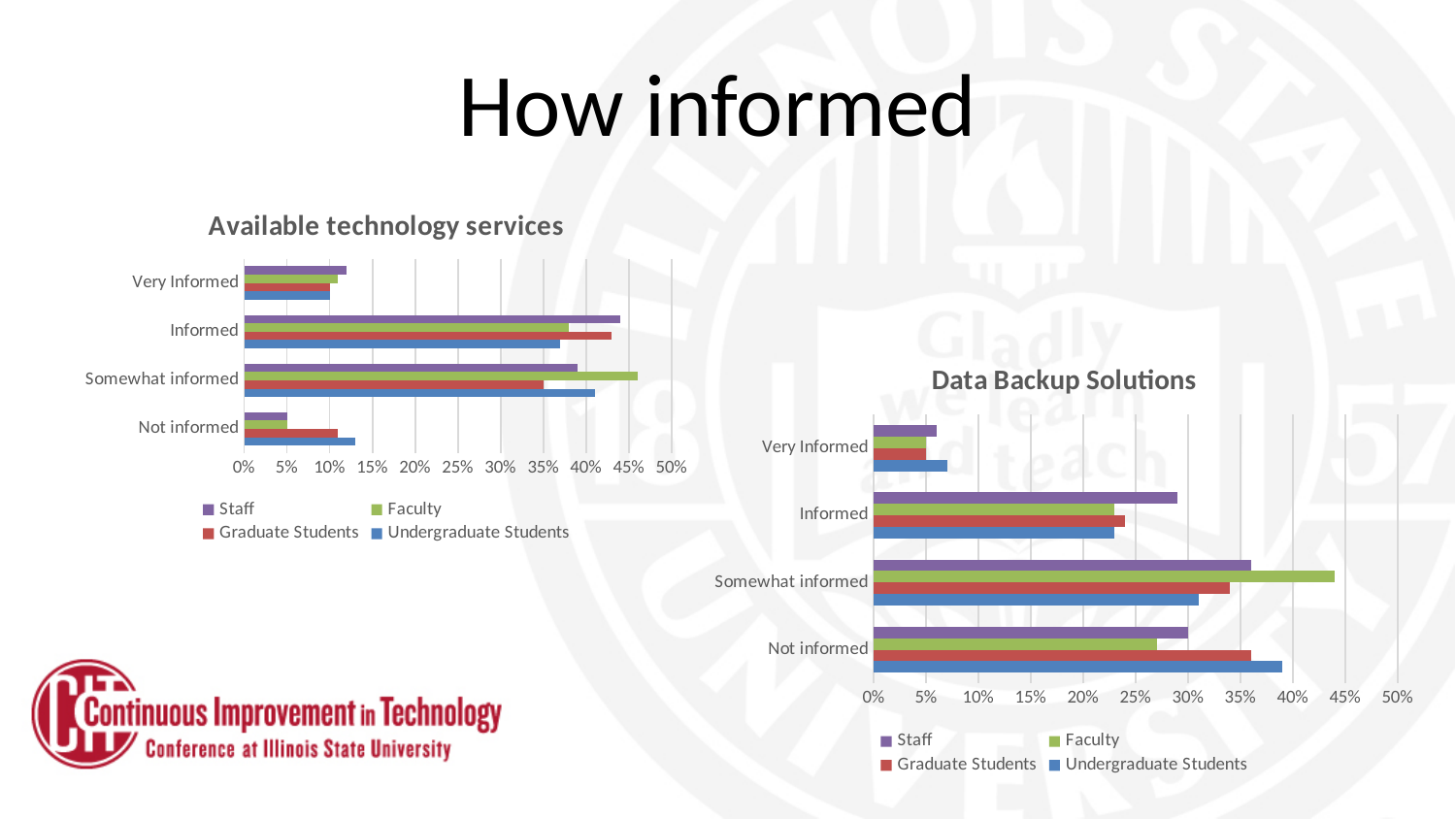
In the "Data Backup Solutions" chart, which series has the highest value for Somewhat informed? Faculty In the "Data Backup Solutions" chart, is the Staff value for Very Informed greater or less than 10%? less In the "Available technology services" chart, is the Faculty value for Somewhat informed greater or less than 40%? greater How many series does the legend of the "Data Backup Solutions" chart list? 4 In the "Available technology services" chart, for Not informed, which is larger: Undergraduate Students or Staff? Undergraduate Students What colour represents Faculty in the legend of the "Data Backup Solutions" chart? Green In the "Data Backup Solutions" chart, is the Undergraduate Students value for Not informed greater or less than 35%? greater In the "Available technology services" chart, which series has the highest value for Somewhat informed? Faculty How many categories are shown on the y axis of the "Available technology services" chart? 4 What kind of chart is the "Available technology services" chart? Bar chart In the "Data Backup Solutions" chart, for Informed, which is larger: Staff or Faculty? Staff